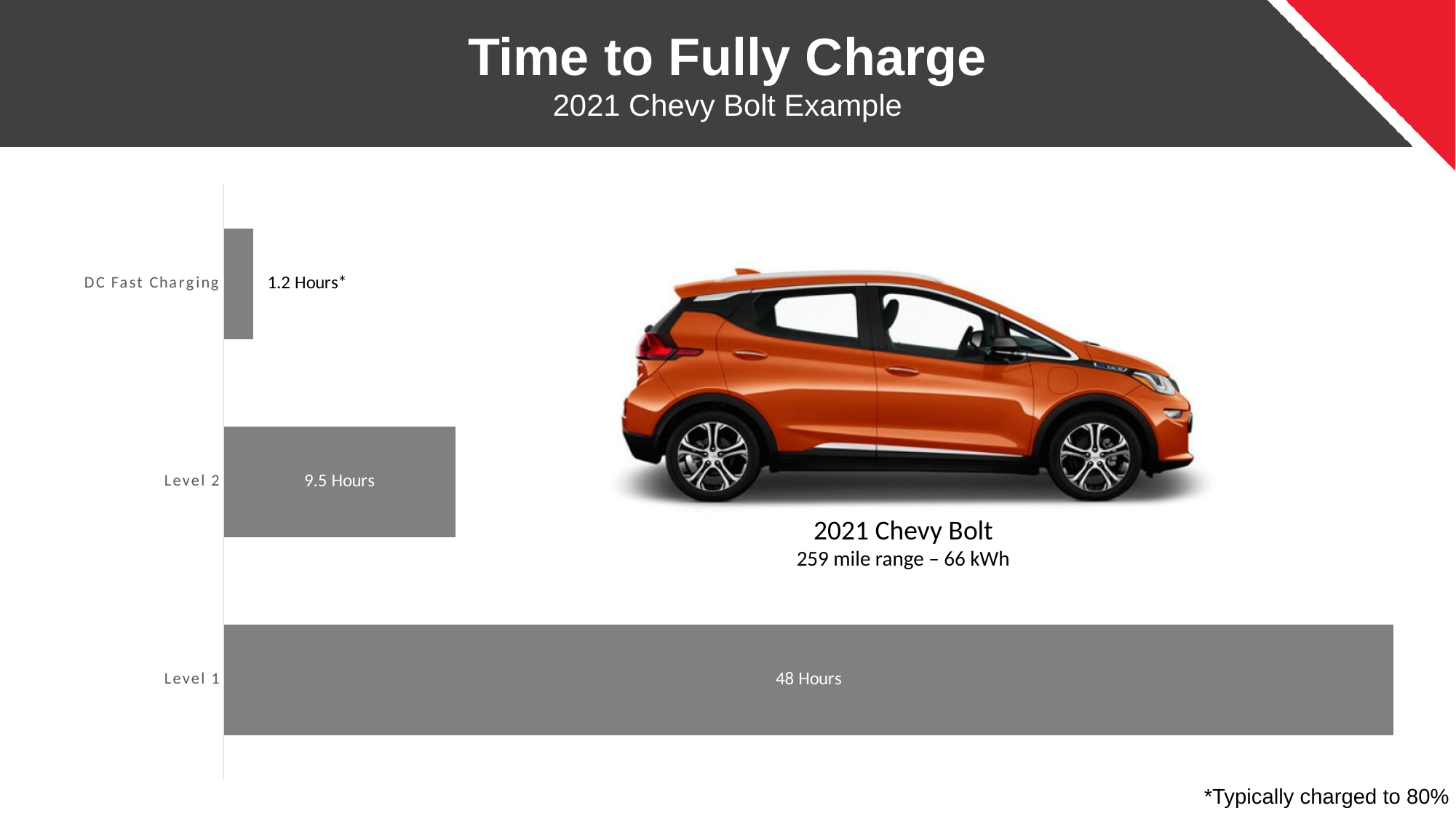
What kind of chart is shown on the slide? Bar chart Which takes longer to charge, Level 2 or DC Fast Charging? Level 2 How many charging options are shown in the chart? 3 Which charging option has the shortest charging time? DC Fast Charging What is the title of the slide containing the chart? Time to Fully Charge What is the charging time shown for Level 1? 48 Hours How many hours longer does Level 1 take than Level 2? 38.5 Hours How many hours longer does Level 2 take than DC Fast Charging? 8.3 Hours What is the charging time shown for DC Fast Charging? 1.2 Hours* Which charging level has the longest time to fully charge? Level 1 What is the charging time shown for Level 2? 9.5 Hours What does the asterisk next to the DC Fast Charging value indicate? Typically charged to 80%